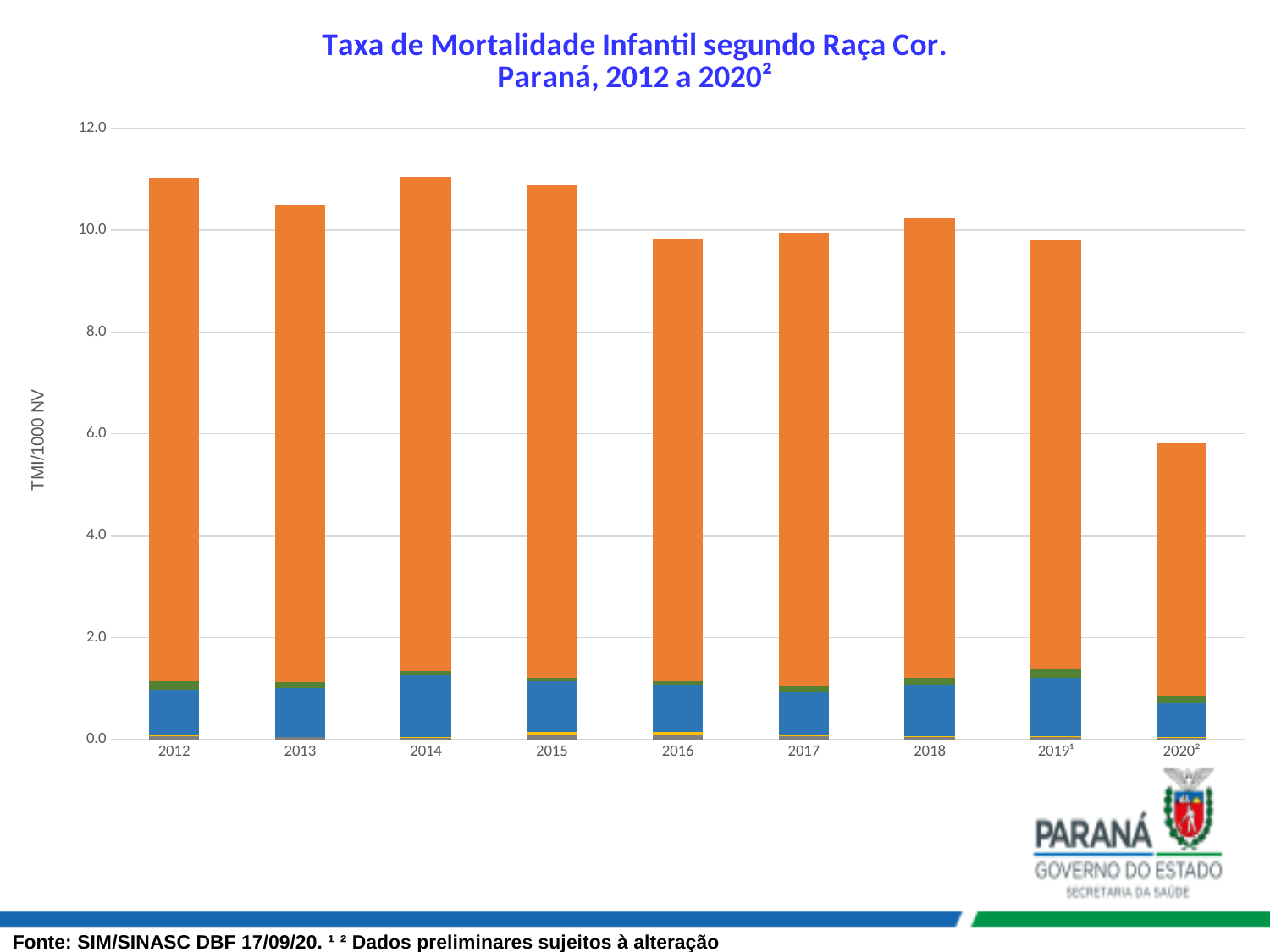
Is the total value for 2019¹ greater or less than 10.0? less Is the total value for 2012 greater or less than 10.0? greater Is the total value for 2016 greater or less than 10.0? less Which year has the larger total bar, 2018 or 2016? 2018 Do the total bar heights generally rise or fall from 2012 to 2020²? fall Which year has the larger total bar, 2012 or 2013? 2012 How many years are shown along the x axis of the chart? 9 What is the label on the vertical axis of the chart? TMI/1000 NV What kind of chart is shown on the slide? bar chart Which year has the lowest total bar in the chart? 2020²